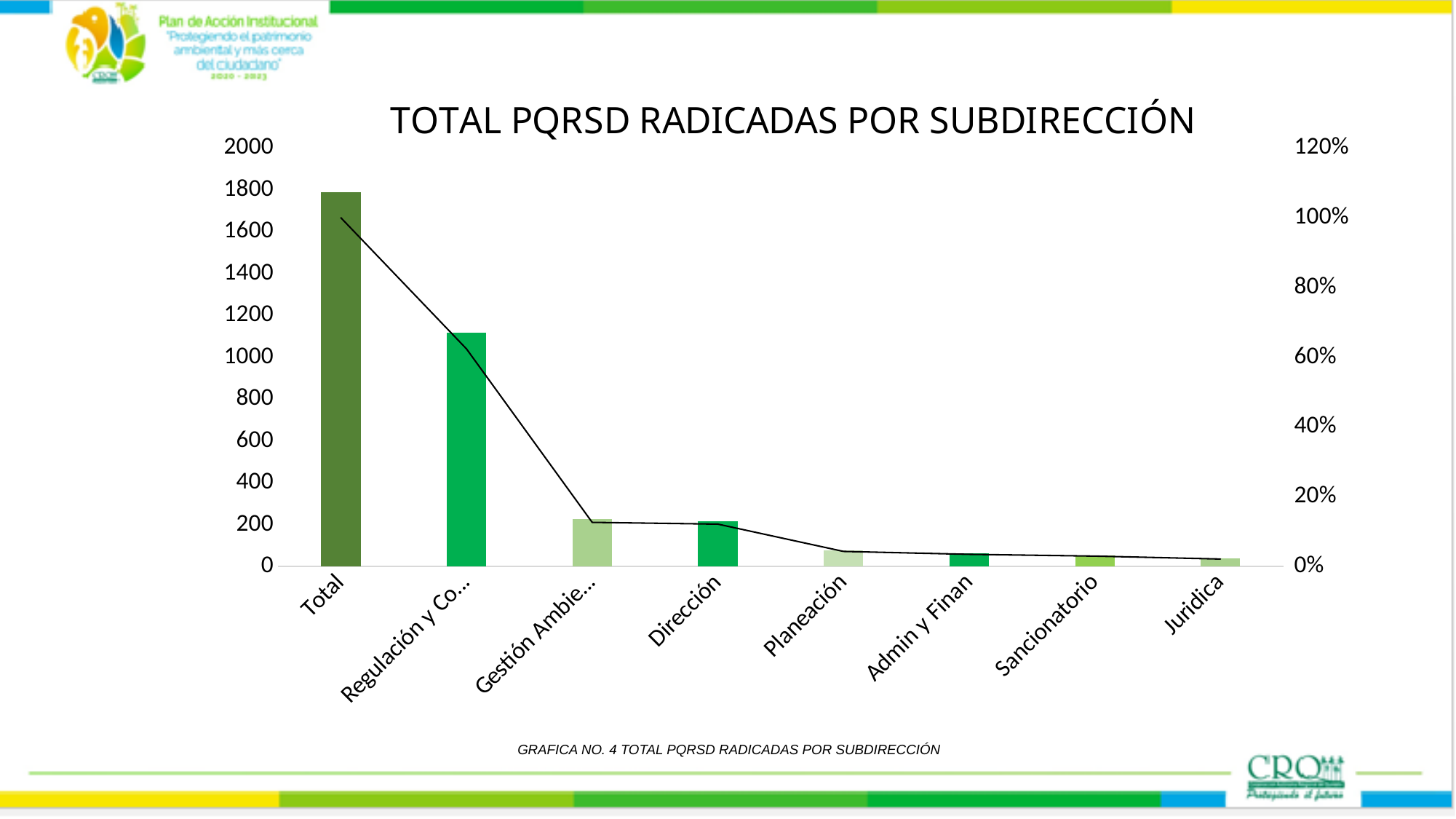
Is the bar value for Planeación greater or less than 200? less Is the bar value for Total greater or less than 1600? greater What kind of chart is shown on the slide? Bar chart with a line What is the title of the chart? TOTAL PQRSD RADICADAS POR SUBDIRECCIÓN Which bar is taller, Total or Regulación y Co...? Total How many categories are shown on the x axis of the chart? 8 Is the bar value for Regulación y Co... greater or less than 1000? greater Do the bar values generally rise or fall from left to right along the x axis? fall Which bar is taller, Regulación y Co... or Dirección? Regulación y Co... Which category has the highest bar in the chart? Total